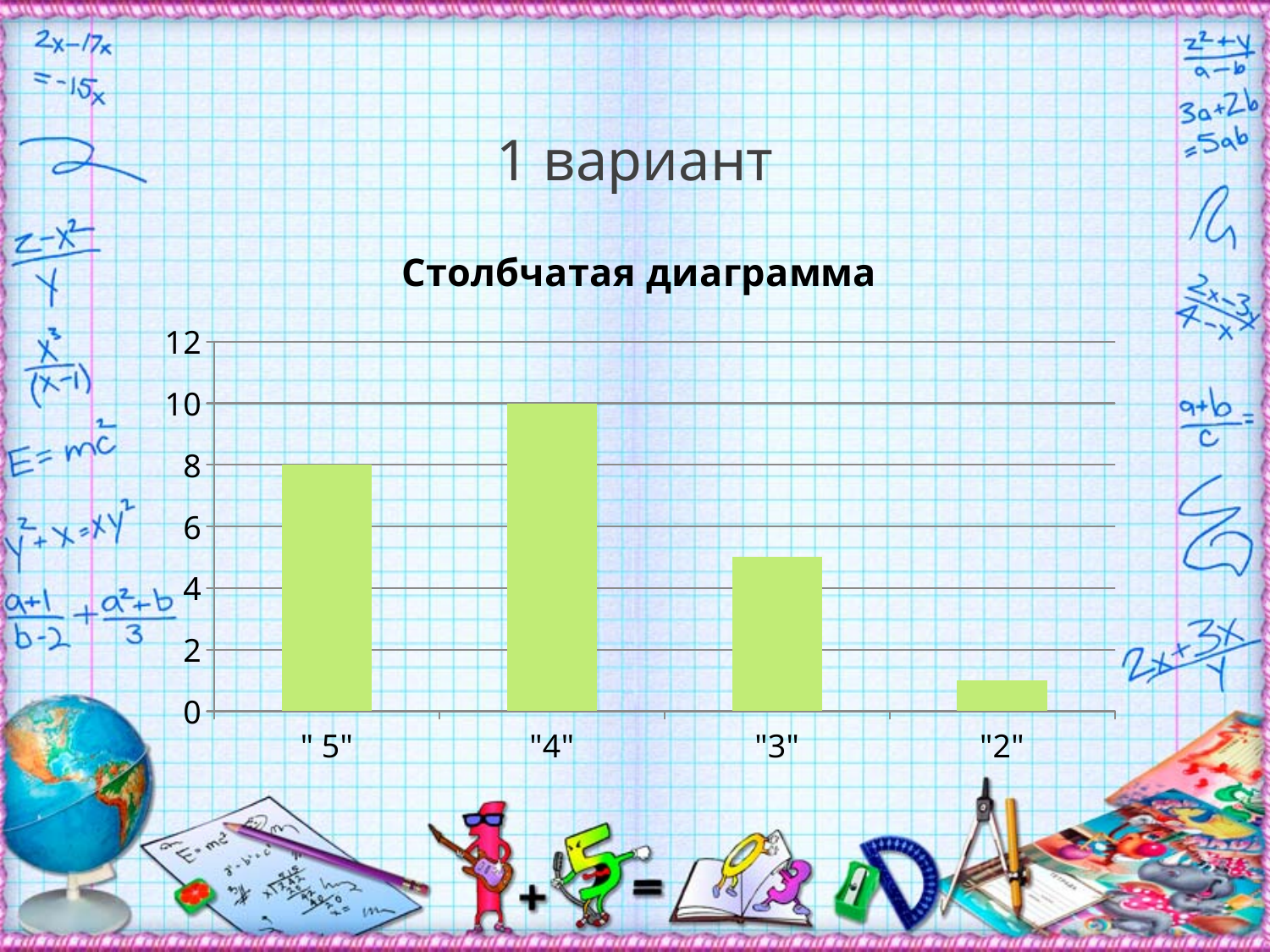
What is the value for the category "4"? 10 What is the difference between the values for "4" and "5"? 2 Which category has the lowest bar? "2" Is the value for "3" greater or less than 4? greater Is the value for "2" greater or less than 2? less What kind of chart is shown on the slide? bar chart Is the value for "3" greater or less than 6? less What is the value for the category "5"? 8 Which is larger, the value for "5" or the value for "3"? "5" What is the title of the chart? Столбчатая диаграмма Which category has the highest bar? "4" How many categories are shown on the x axis? 4